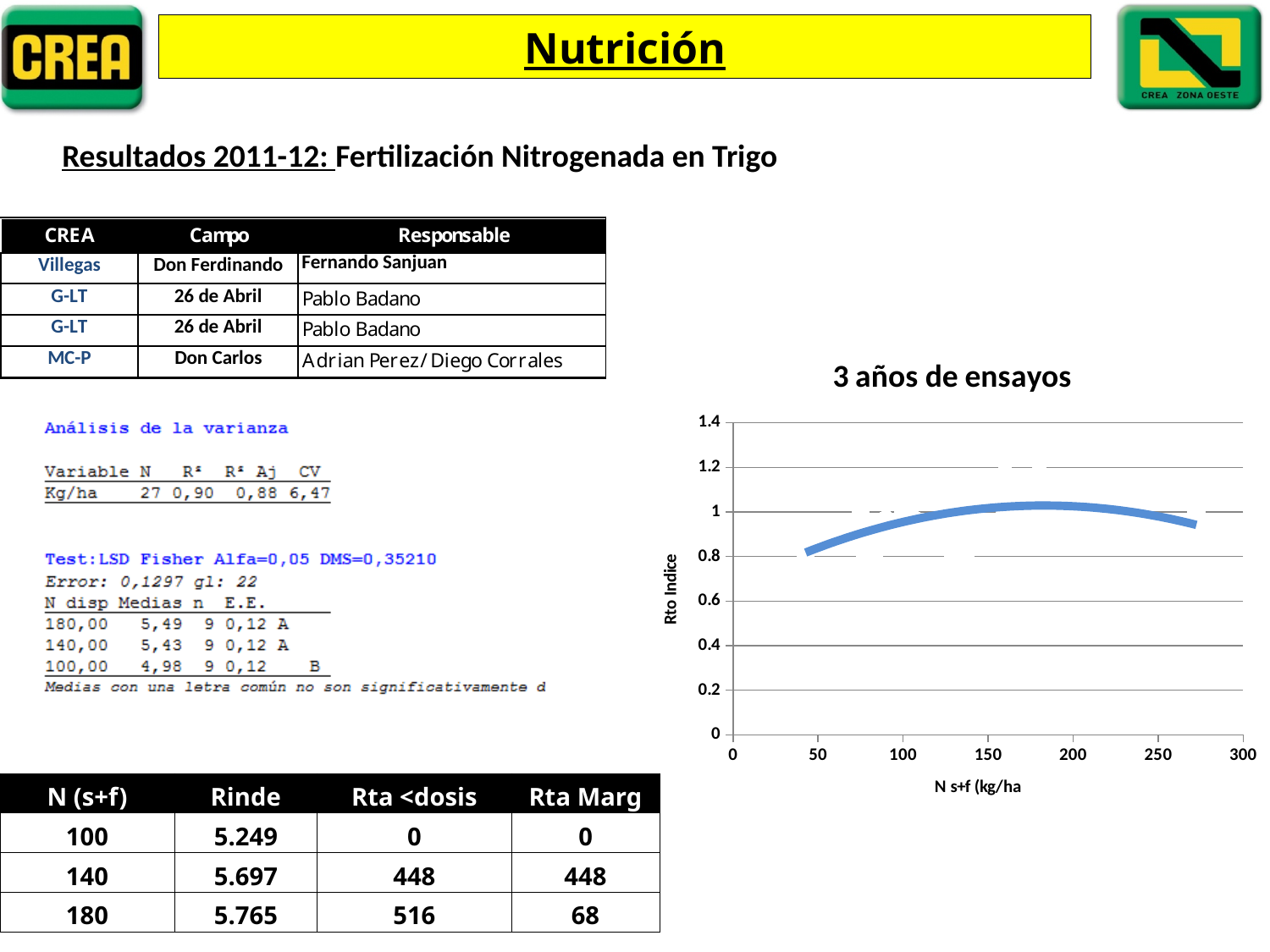
In the chart '3 años de ensayos', is the value of the curve at N s+f = 100 greater or less than 0.6? greater In the chart '3 años de ensayos', is the value of the curve at N s+f = 50 greater or less than 1? less What kind of chart is '3 años de ensayos'? line chart In the chart '3 años de ensayos', does the curve rise or fall between N s+f = 50 and N s+f = 150? rise In the chart '3 años de ensayos', which is larger: the curve value at N s+f = 50 or at N s+f = 150? N s+f = 150 In the chart '3 años de ensayos', does the curve rise or fall between N s+f = 200 and N s+f = 270? fall In the chart '3 años de ensayos', is the value of the curve at N s+f = 150 greater or less than 0.8? greater What is the title of the chart on the right side of the slide? 3 años de ensayos In the chart '3 años de ensayos', what is the highest value shown on the vertical axis? 1.4 In the chart '3 años de ensayos', what is the label of the vertical axis? Rto Indice